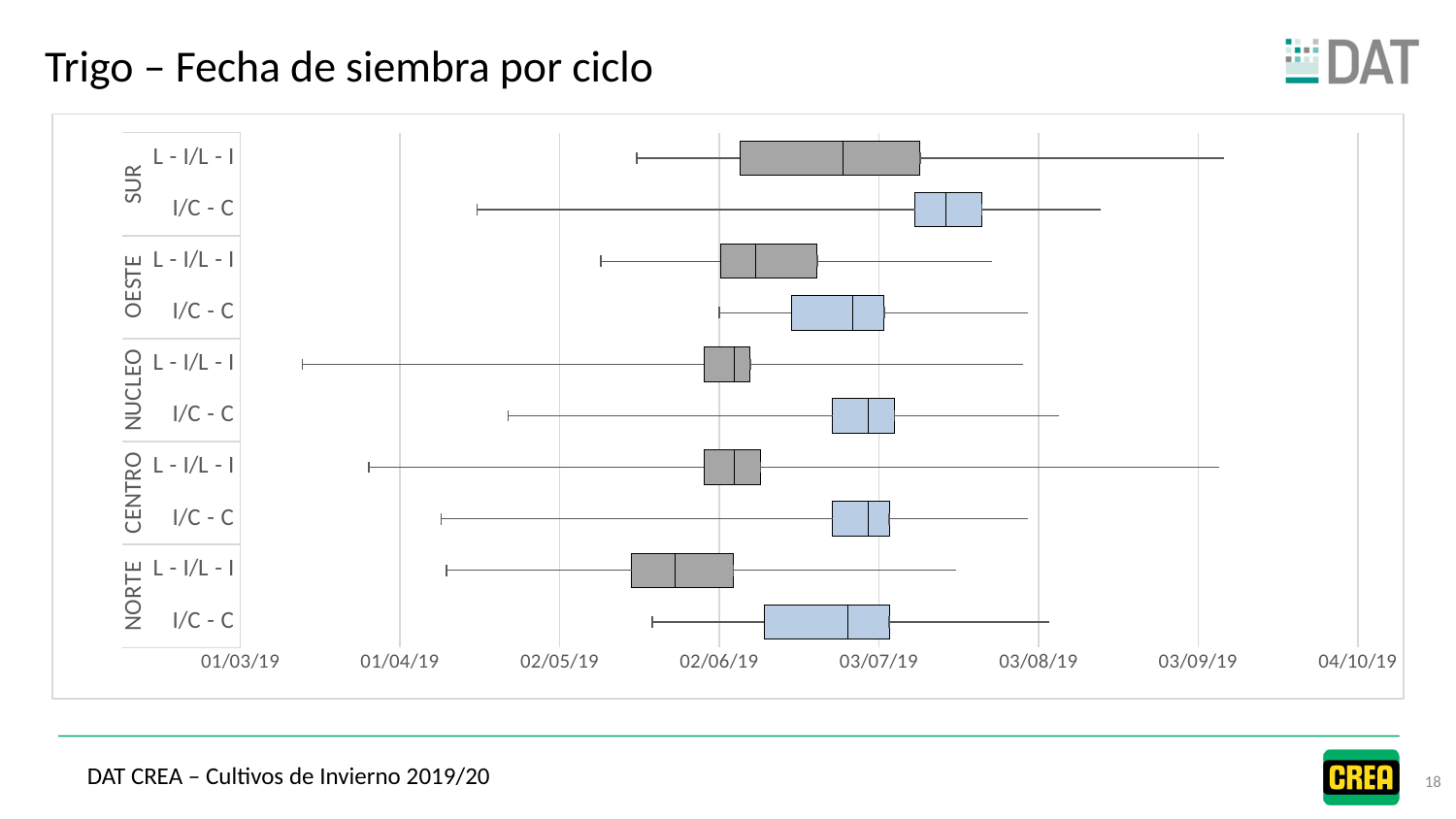
What kind of chart is shown on the slide? Box plot How many regions are listed on the vertical axis of the chart? 5 Is the median sowing date for NUCLEO L - I/L - I before or after 03/07/19? before Which region has the widest box for the L - I/L - I cycle? SUR In the NORTE region, which cycle has the earlier median sowing date, L - I/L - I or I/C - C? L - I/L - I Is the median sowing date for SUR I/C - C before or after 03/07/19? after What is the title of the slide's chart? Trigo – Fecha de siembra por ciclo Is the median sowing date for OESTE L - I/L - I before or after 02/06/19? after Which two cycle labels are shown for each region? L - I/L - I and I/C - C In the SUR region, which cycle has the later median sowing date, L - I/L - I or I/C - C? I/C - C Which region's I/C - C box has the latest median sowing date? SUR How many boxes (region–cycle combinations) are plotted in the chart? 10